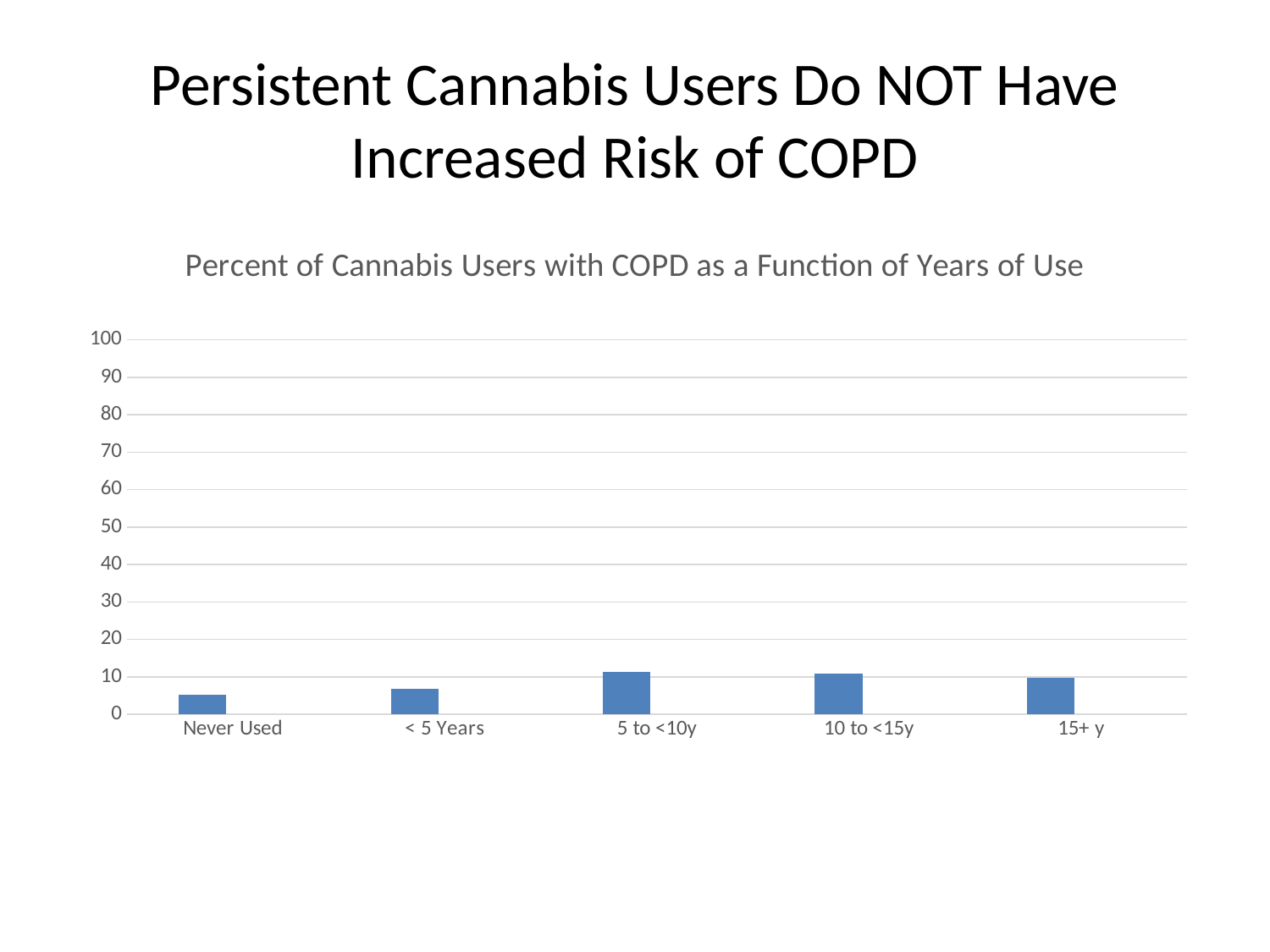
Do the values rise or fall from Never Used to 5 to <10y? rise What is the maximum value shown on the y axis of the chart? 100 Which is larger, the value for Never Used or the value for 5 to <10y? 5 to <10y How many categories are shown on the x axis of the chart? 5 What kind of chart is shown on the slide? bar chart What is the title of the chart? Percent of Cannabis Users with COPD as a Function of Years of Use Is the value for 15+ y greater or less than 20? less Which is larger, the value for < 5 Years or the value for 15+ y? 15+ y Is the value for 5 to <10y greater or less than 10? greater Is the value for < 5 Years greater or less than 10? less Which category has the lowest value in the chart? Never Used